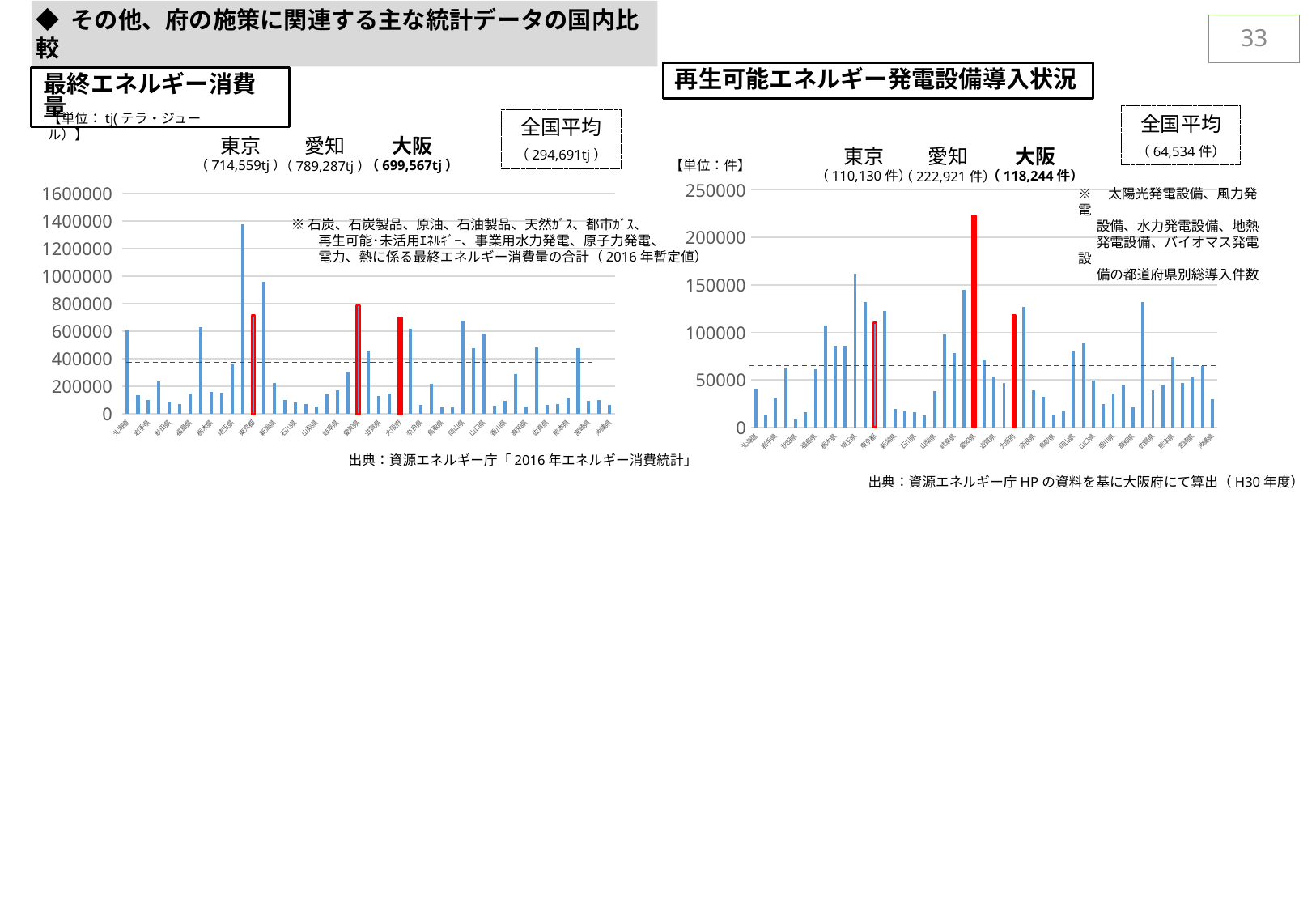
In the 再生可能エネルギー発電設備導入状況 chart on the right, what is the 全国平均 (national average) shown? 64,534件 In the 再生可能エネルギー発電設備導入状況 chart on the right, which of 東京, 愛知 and 大阪 has the highest printed value? 愛知 In the 再生可能エネルギー発電設備導入状況 chart on the right, what is the difference between the printed values for 愛知 and 大阪? 104,677件 In the 再生可能エネルギー発電設備導入状況 chart on the right, which is larger, the printed value for 東京 or for 大阪? 大阪 In the 再生可能エネルギー発電設備導入状況 chart on the right, what is the value printed for 愛知? 222,921件 In the 最終エネルギー消費量 chart on the left, which of 東京, 愛知 and 大阪 has the lowest printed value? 大阪 In the 最終エネルギー消費量 chart on the left, what is the 全国平均 (national average) shown? 294,691tj In the 最終エネルギー消費量 chart on the left, what is the difference between the printed values for 東京 and 大阪? 14,992tj What kind of chart is the 最終エネルギー消費量 chart on the left? bar chart In the 再生可能エネルギー発電設備導入状況 chart on the right, is the value for 大阪府 greater or less than 100000? greater In the 最終エネルギー消費量 chart on the left, what is the value printed for 大阪? 699,567tj In the 再生可能エネルギー発電設備導入状況 chart on the right, what colour are the bars for 東京都, 愛知県 and 大阪府 highlighted in? red